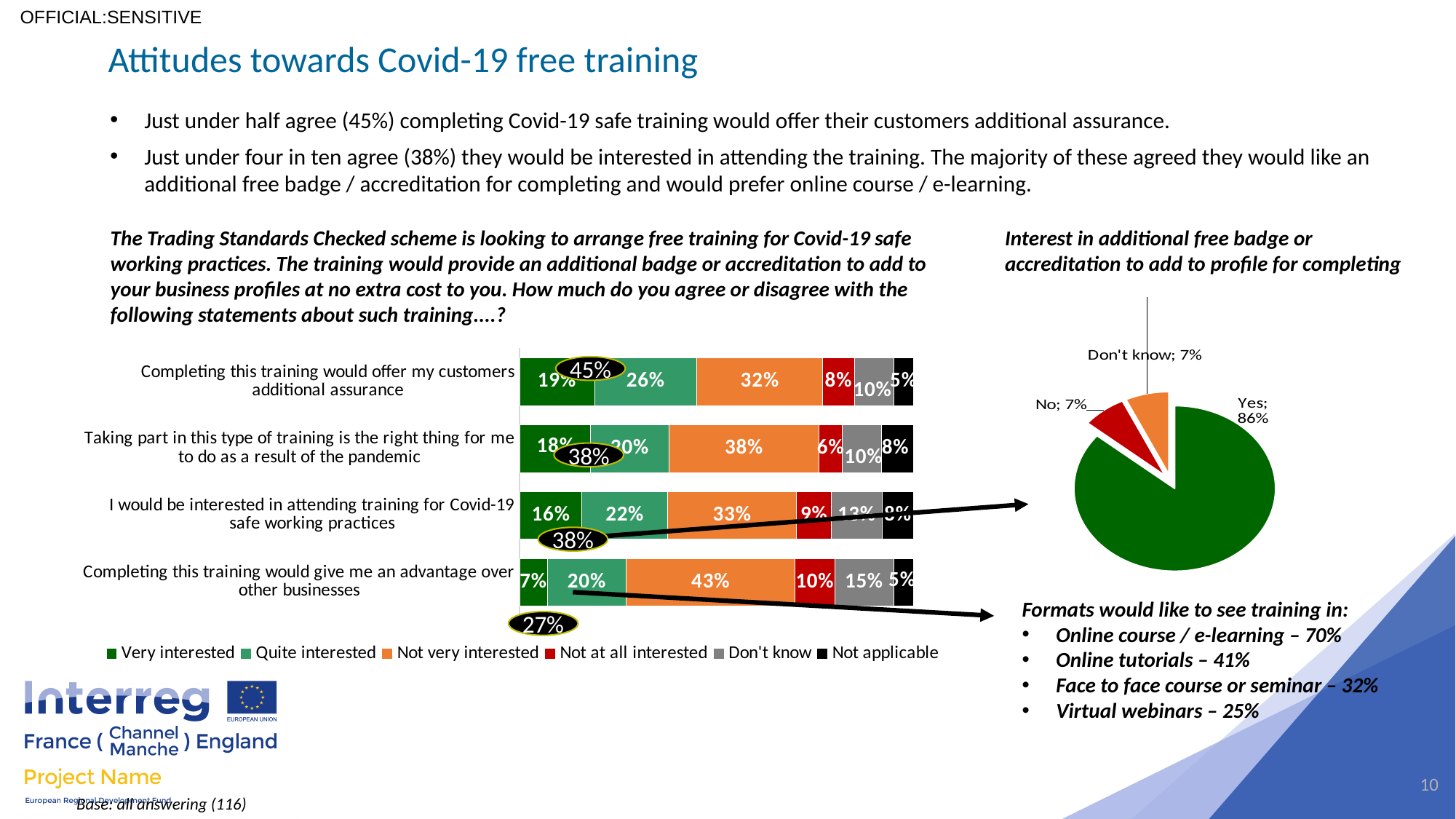
In the stacked bar chart on the left, what is the difference between the 'Not very interested' values for 'Completing this training would give me an advantage over other businesses' and 'Completing this training would offer my customers additional assurance'? 11% In the pie chart titled 'Interest in additional free badge or accreditation to add to profile for completing', what share of respondents answered 'Yes'? 86% In the pie chart on the right, which response has the largest slice? Yes In the stacked bar chart on the left, how many series does the legend list? 6 In the stacked bar chart on the left, which statement has the lowest 'Very interested' value? Completing this training would give me an advantage over other businesses In the stacked bar chart on the left, what is the 'Not very interested' value for 'Completing this training would give me an advantage over other businesses'? 43% In the pie chart on the right, how many slices are there? 3 What type of chart is shown on the left of the slide? Stacked bar chart In the stacked bar chart on the left, what is the 'Not at all interested' value for 'I would be interested in attending training for Covid-19 safe working practices'? 9% In the pie chart on the right, what percentage answered 'Don't know'? 7% In the stacked bar chart on the left, what is the 'Very interested' value for 'Completing this training would offer my customers additional assurance'? 19% In the stacked bar chart on the left, how many statements (categories) are shown? 4